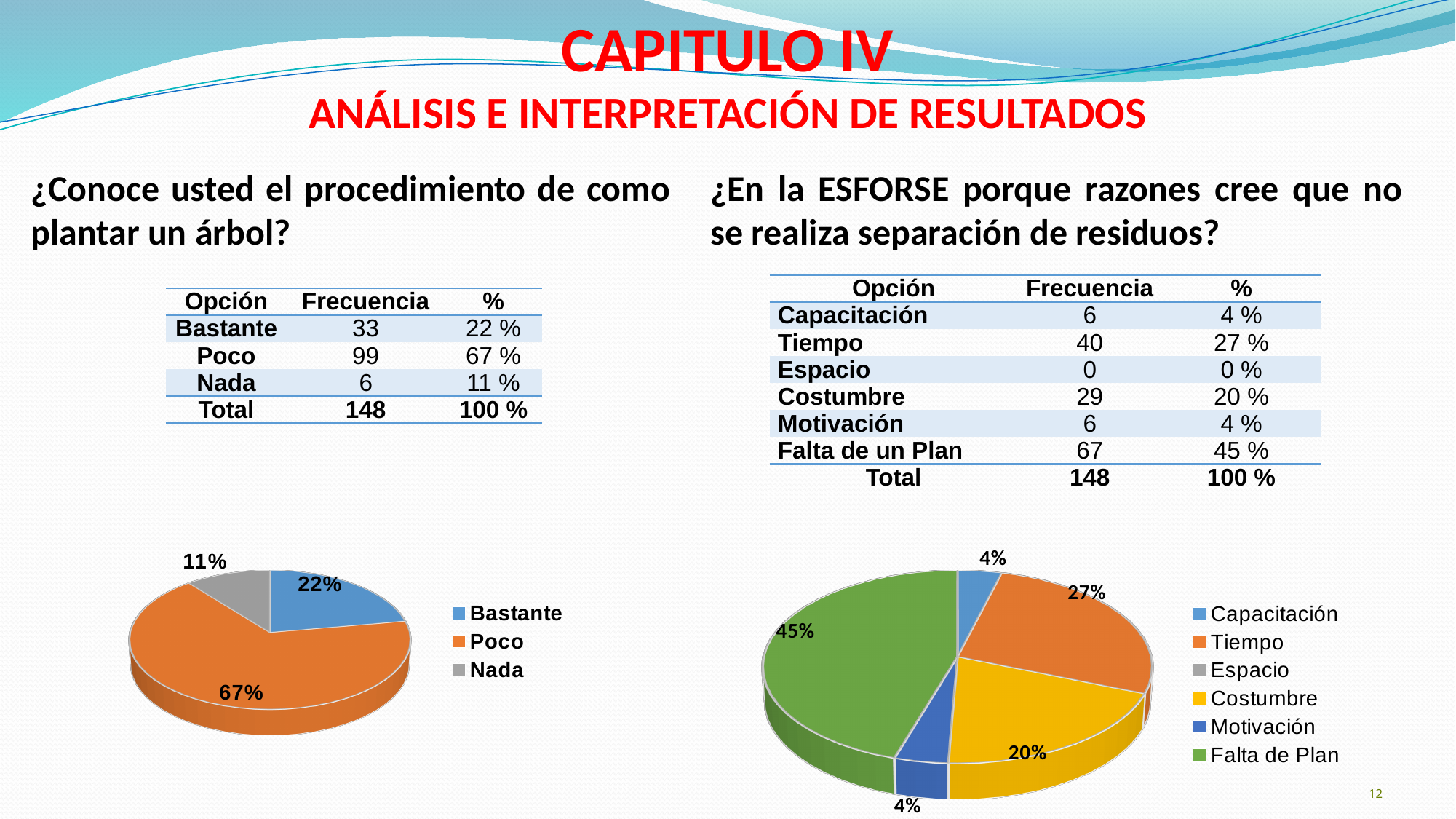
In the left pie chart, how many categories does the legend list? 3 In the right pie chart, which category has the largest slice? Falta de Plan In the left pie chart, which category has the smallest slice? Nada In the left pie chart, what share is labelled for Nada? 11% In the left pie chart, which category has the largest slice? Poco In the right pie chart, how many entries does the legend list? 6 In the right pie chart, what is the difference in percentage points between Tiempo and Costumbre? 7 What kind of chart is the left chart (about knowing how to plant a tree)? Pie chart In the right pie chart, what share is labelled for Costumbre? 20% In the right pie chart, which is larger, Tiempo or Costumbre? Tiempo In the left pie chart, what share is labelled for Poco? 67% In the right pie chart (reasons for not separating waste), what share is labelled for Falta de Plan? 45%